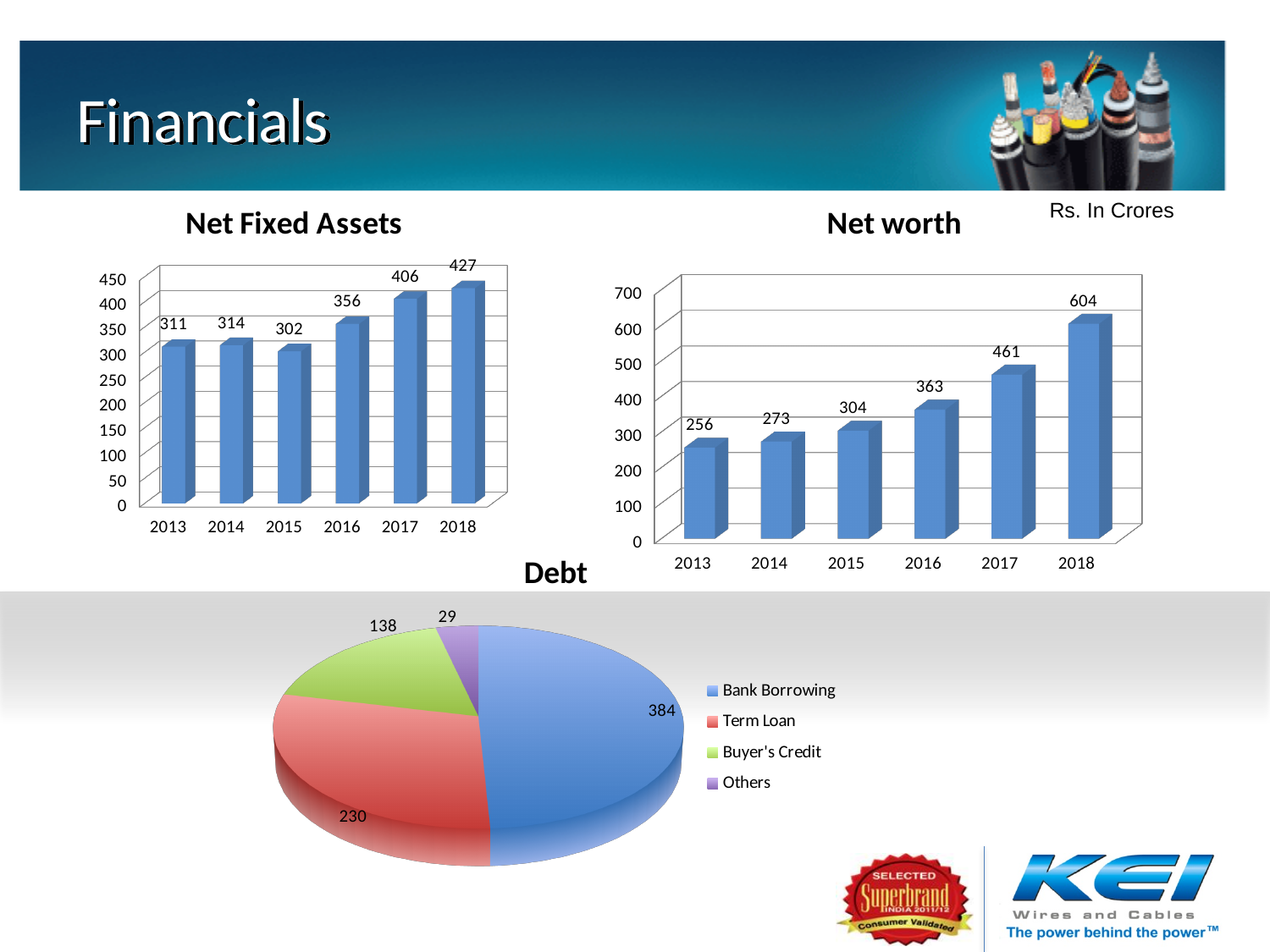
In the Net worth chart, what is the value for 2018? 604 In the Net Fixed Assets chart, which year has the lowest value? 2015 How many categories does the legend of the Debt pie chart list? 4 In the Net worth chart, is the value for 2016 greater or less than 400? less In the Net Fixed Assets chart, what is the difference between the 2018 and 2013 values? 116 In the Debt pie chart, what is the value for Term Loan? 230 In the Debt pie chart, what is the total of all four slices? 781 In the Net Fixed Assets chart, what is the value for 2016? 356 What kind of chart is the Net worth chart? Bar chart In the Net worth chart, which year has the highest value? 2018 In the Debt pie chart, which category has the largest slice? Bank Borrowing In the Net worth chart, what is the difference between the 2018 and 2017 values? 143